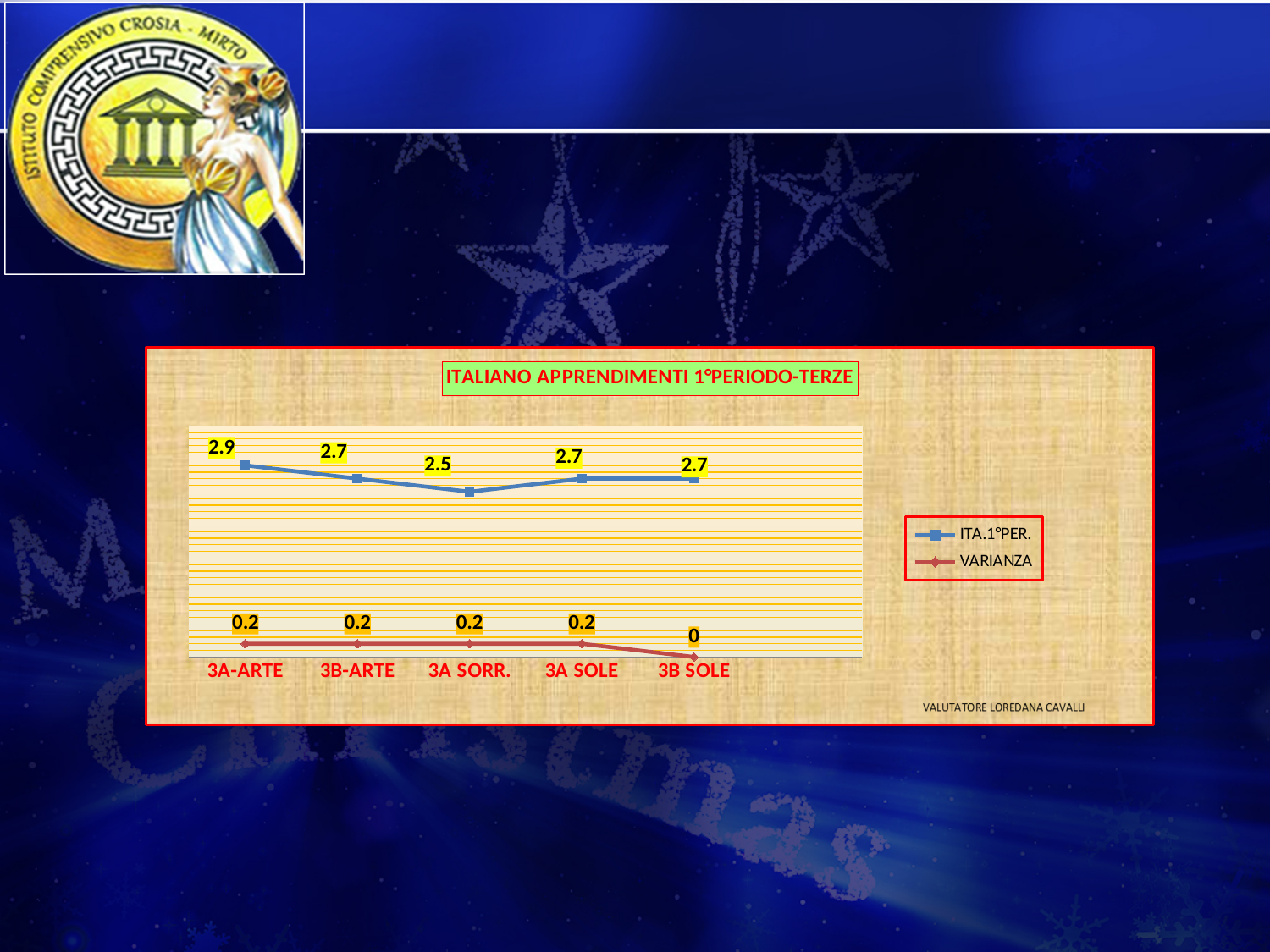
What is the difference between the ITA.1°PER. values for 3A-ARTE and 3A SORR.? 0.4 Which is larger, the ITA.1°PER. value for 3B-ARTE or for 3A SORR.? 3B-ARTE How many series does the legend list? 2 How many categories are shown on the x axis? 5 What kind of chart is shown? line chart What is the VARIANZA value for 3A SOLE? 0.2 What is the title of the chart? ITALIANO APPRENDIMENTI 1°PERIODO-TERZE Which category has the lowest ITA.1°PER. value? 3A SORR. What is the ITA.1°PER. value for 3A-ARTE? 2.9 What is the ITA.1°PER. value for 3A SORR.? 2.5 What is the VARIANZA value for 3B SOLE? 0 Which category has the highest ITA.1°PER. value? 3A-ARTE